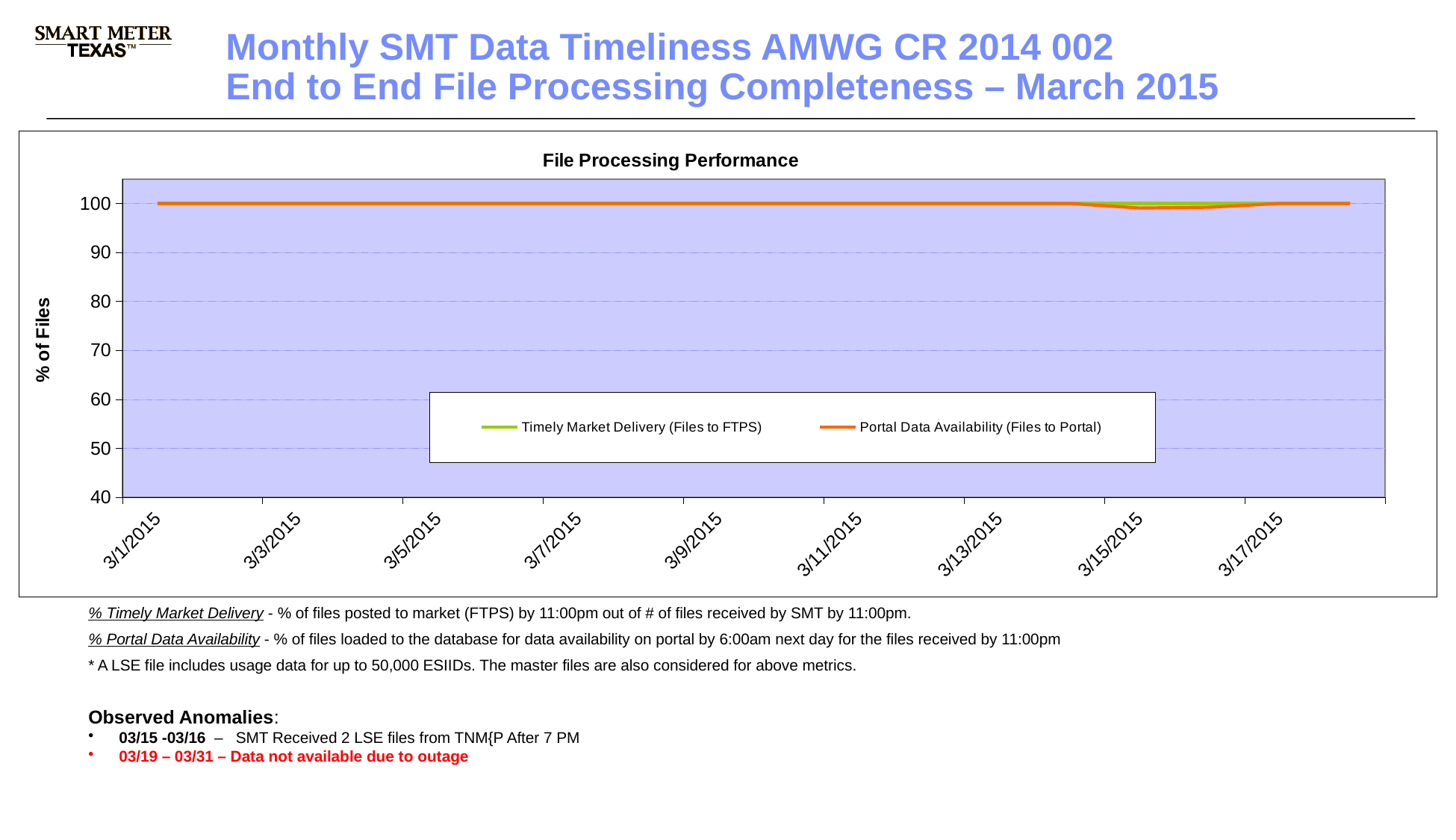
How many series does the chart legend list? 2 What is the lowest value shown on the vertical axis? 40 Is the value for Portal Data Availability (Files to Portal) on 3/15/2015 greater or less than 90? greater What is the title of the chart? File Processing Performance Which series shows a visible dip below the other around 3/15/2015? Portal Data Availability (Files to Portal) Is the value for Portal Data Availability (Files to Portal) on 3/5/2015 greater or less than 70? greater Is the value for Timely Market Delivery (Files to FTPS) on 3/1/2015 greater or less than 90? greater What is the first date label shown on the x axis? 3/1/2015 What kind of chart is shown on the slide? line chart